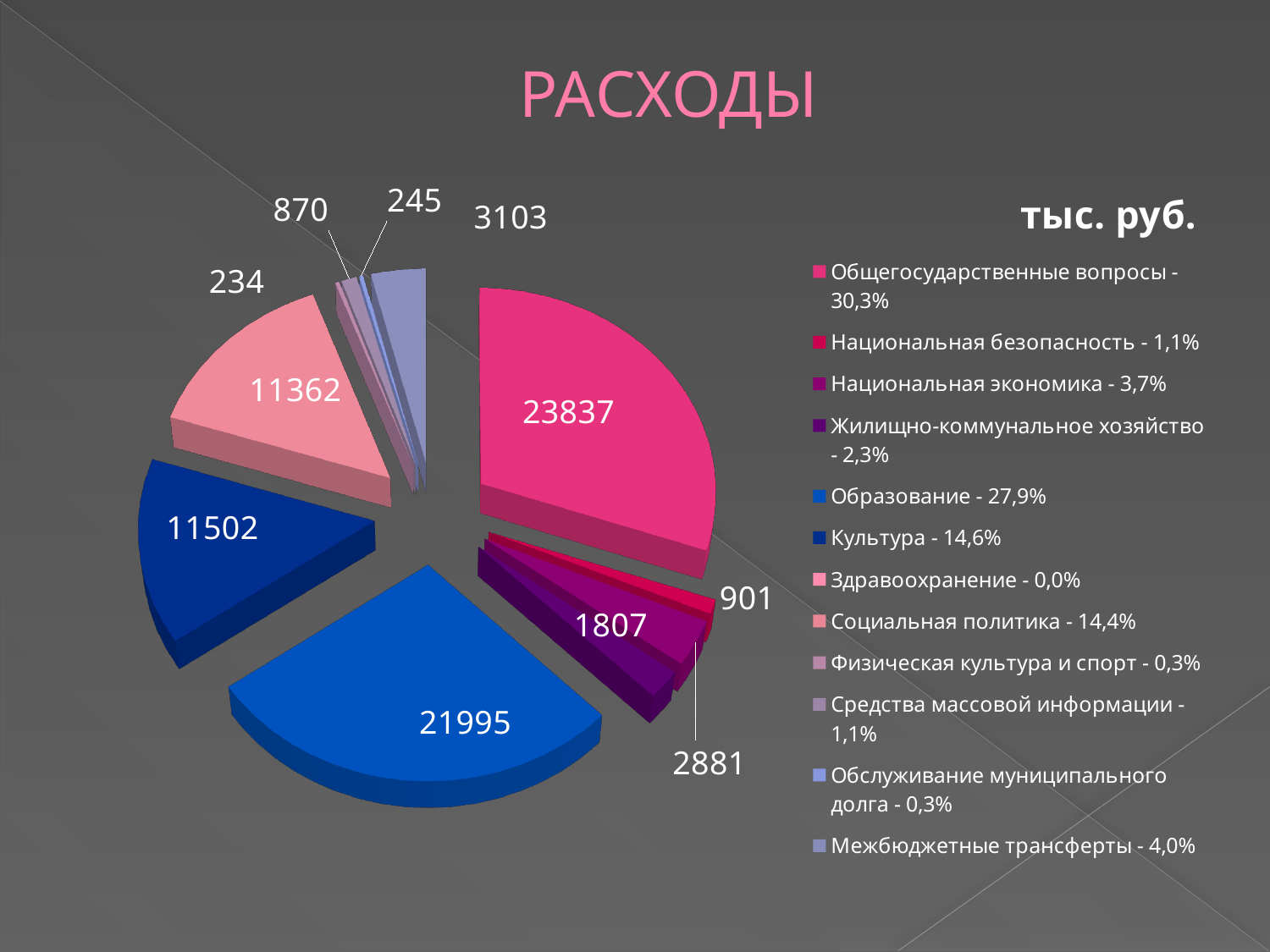
Which is larger, the value for Культура or the value for Социальная политика? Культура How many categories does the legend list? 12 What is the value for Образование? 21995 What unit is stated for the values on the chart? тыс. руб. What is the difference between the values for Общегосударственные вопросы and Образование? 1842 What is the value for Культура? 11502 What kind of chart is shown on the slide? pie chart What is the value for Общегосударственные вопросы? 23837 Which category has the largest slice of the pie? Общегосударственные вопросы What is the value for Национальная экономика? 2881 What share of the pie does Образование represent, according to the legend? 27,9% What is the value for Социальная политика? 11362